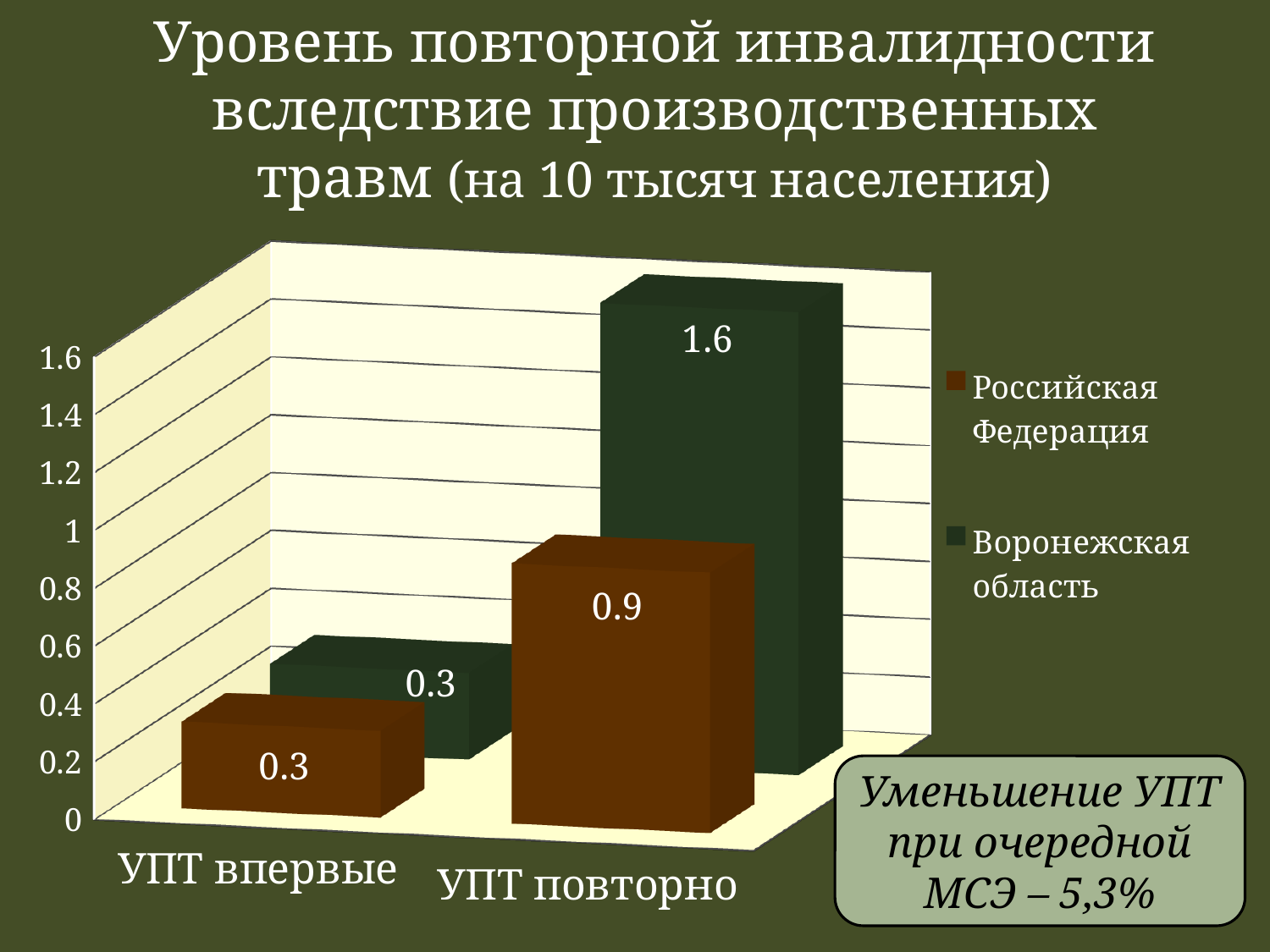
What is the difference between the Воронежская область values for УПТ повторно and УПТ впервые? 1.3 Which is larger: the Российская Федерация value for УПТ повторно or for УПТ впервые? УПТ повторно Which series is shown in dark green in the legend? Воронежская область What is the difference between the Воронежская область and Российская Федерация values in the УПТ повторно category? 0.7 What is the value for Российская Федерация in the УПТ повторно category? 0.9 Which series has the highest value in the УПТ повторно category? Воронежская область What is the value for Воронежская область in the УПТ повторно category? 1.6 How many categories are shown on the x axis? 2 What is the value for Российская Федерация in the УПТ впервые category? 0.3 What is the value for Воронежская область in the УПТ впервые category? 0.3 How many series does the legend list? 2 What kind of chart is shown on the slide? bar chart